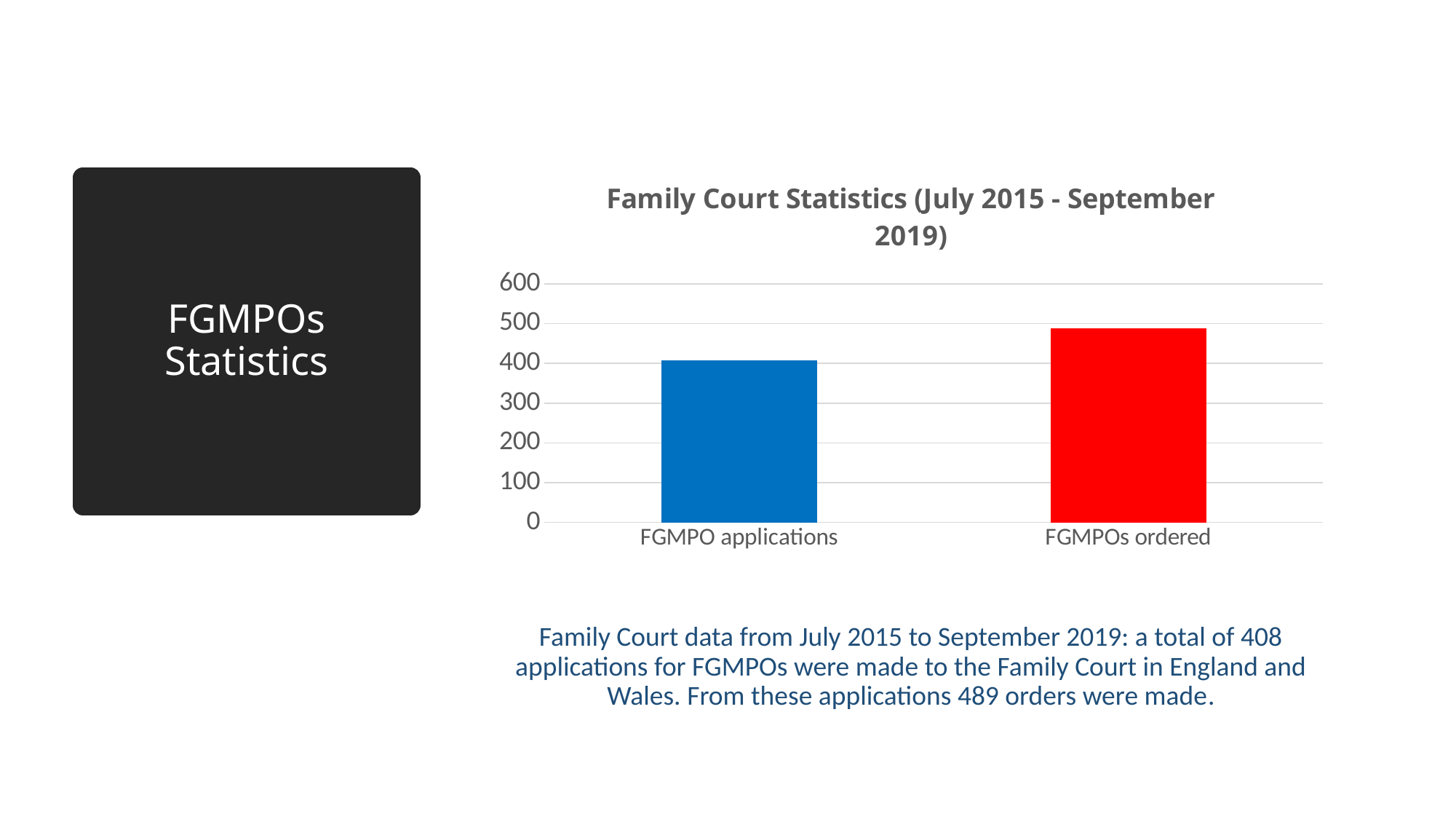
What colour is the bar for FGMPOs ordered? red Is the value for FGMPOs ordered greater or less than 400? greater How many categories are plotted in the chart? 2 Which category has the lowest value in the chart? FGMPO applications Is the value for FGMPO applications greater or less than 300? greater Is the value for FGMPO applications greater or less than 500? less What kind of chart is shown on the slide? bar chart Which category has the highest value in the chart? FGMPOs ordered What is the title of the chart? Family Court Statistics (July 2015 - September 2019) According to the slide, how many FGMPO applications were made to the Family Court between July 2015 and September 2019? 408 According to the slide, how many FGMPOs were ordered between July 2015 and September 2019? 489 Which category has the higher bar, FGMPO applications or FGMPOs ordered? FGMPOs ordered